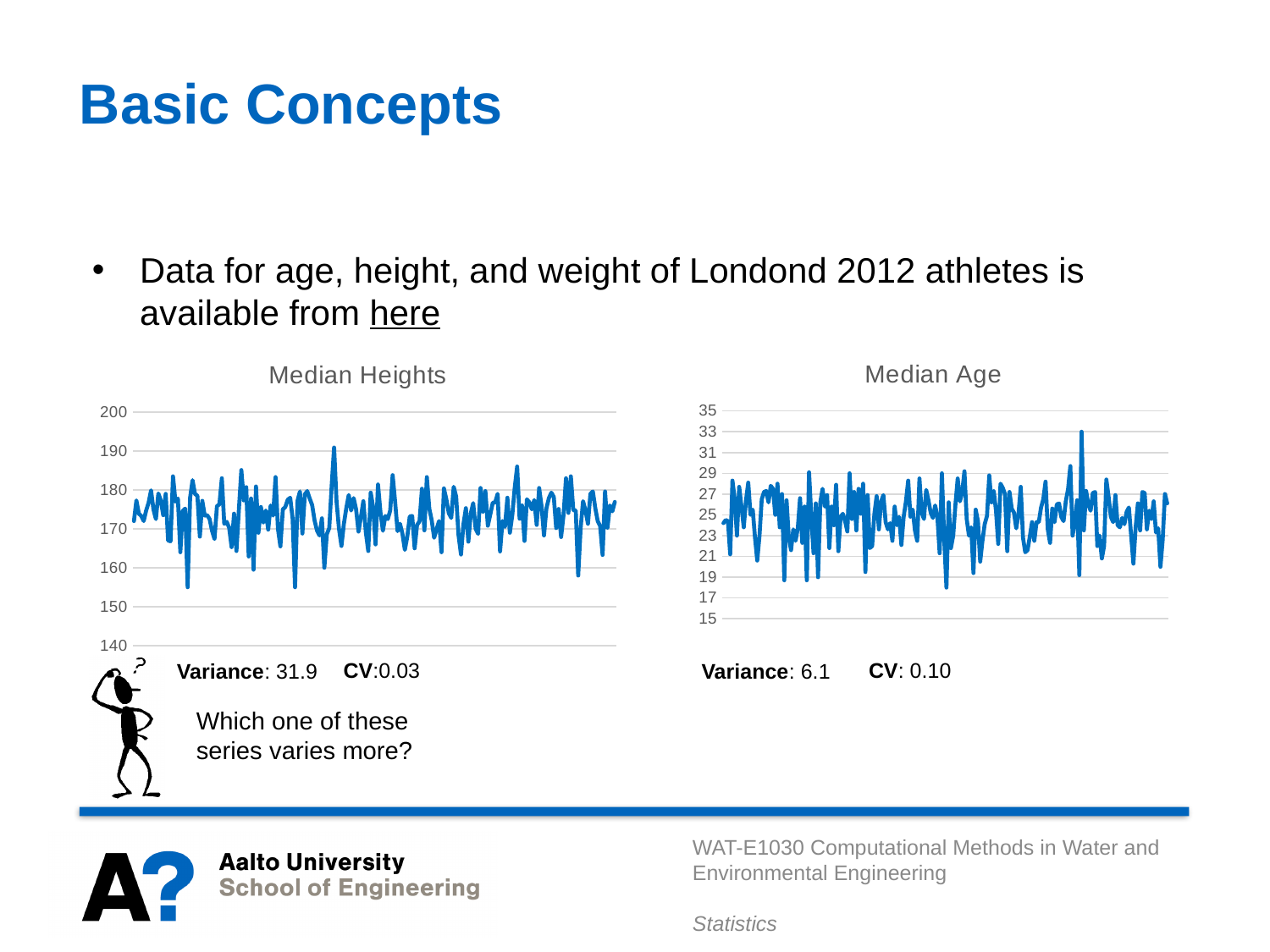
What is the highest value shown on the y axis of the "Median Age" chart? 35 In the "Median Heights" chart, is the highest peak of the series greater or less than 200? less In the "Median Age" chart, is the highest peak of the series greater or less than 31? greater What kind of chart is the "Median Age" chart on the right of the slide? line chart In the "Median Heights" chart, is the lowest point of the series greater or less than 160? less What kind of chart is the "Median Heights" chart on the left of the slide? line chart What is the title of the chart on the left of the slide? Median Heights How many charts are shown on the slide? 2